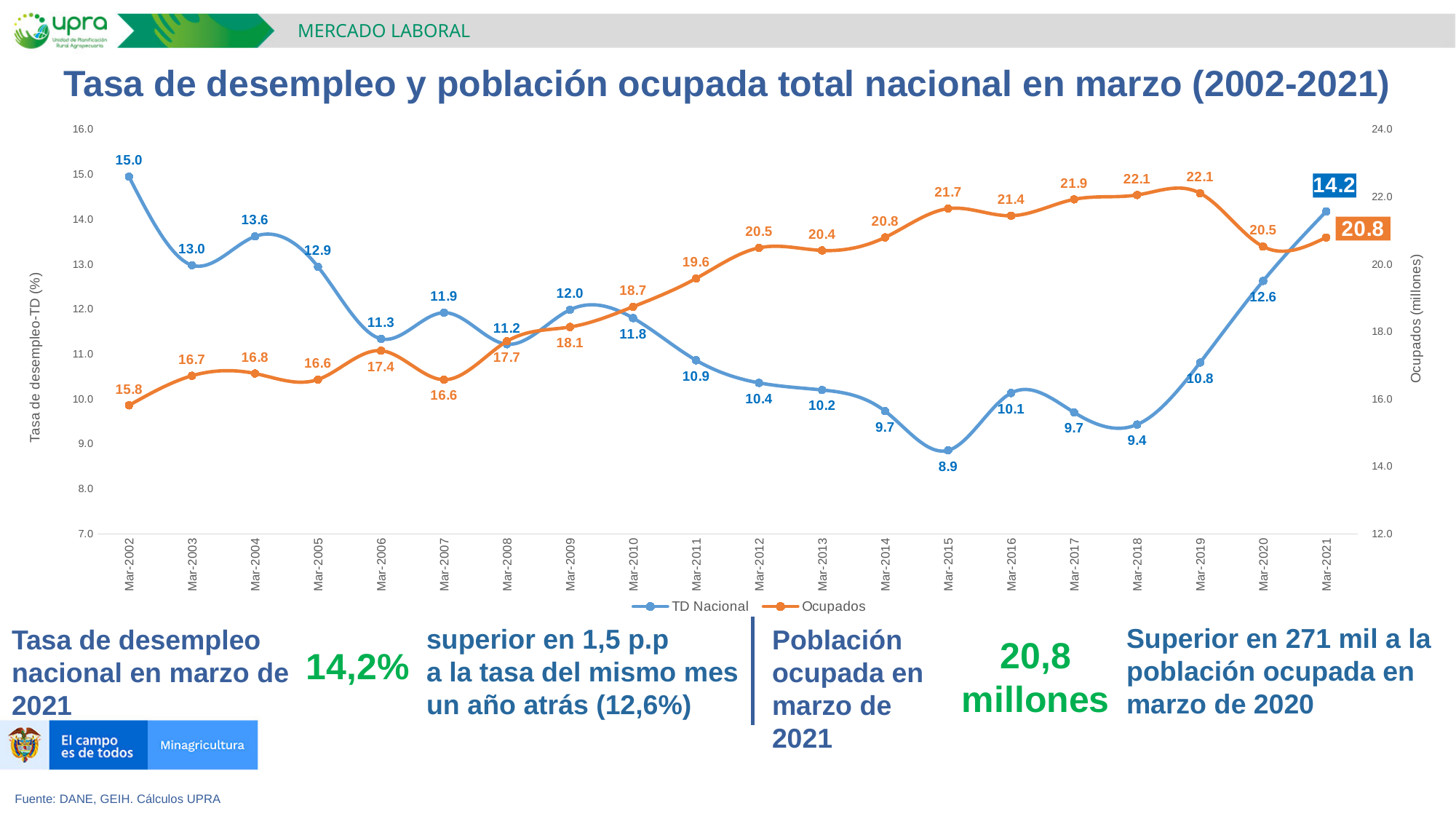
What is the difference between the TD Nacional values for Mar-2021 and Mar-2020? 1.6 What type of chart is shown on the slide? Line chart How many series does the legend list? 2 In which year does TD Nacional reach its lowest value? Mar-2015 Which is larger, the Ocupados value for Mar-2018 or for Mar-2020? Mar-2018 In which year is the Ocupados series at its lowest value? Mar-2002 What is the value of Ocupados for Mar-2015? 21.7 How many time points are plotted on the x axis? 20 In which year does TD Nacional reach its highest value? Mar-2002 Does the Ocupados series generally rise or fall from Mar-2002 to Mar-2019? Rise What is the value of TD Nacional for Mar-2021? 14.2 What is the value of TD Nacional for Mar-2008? 11.2